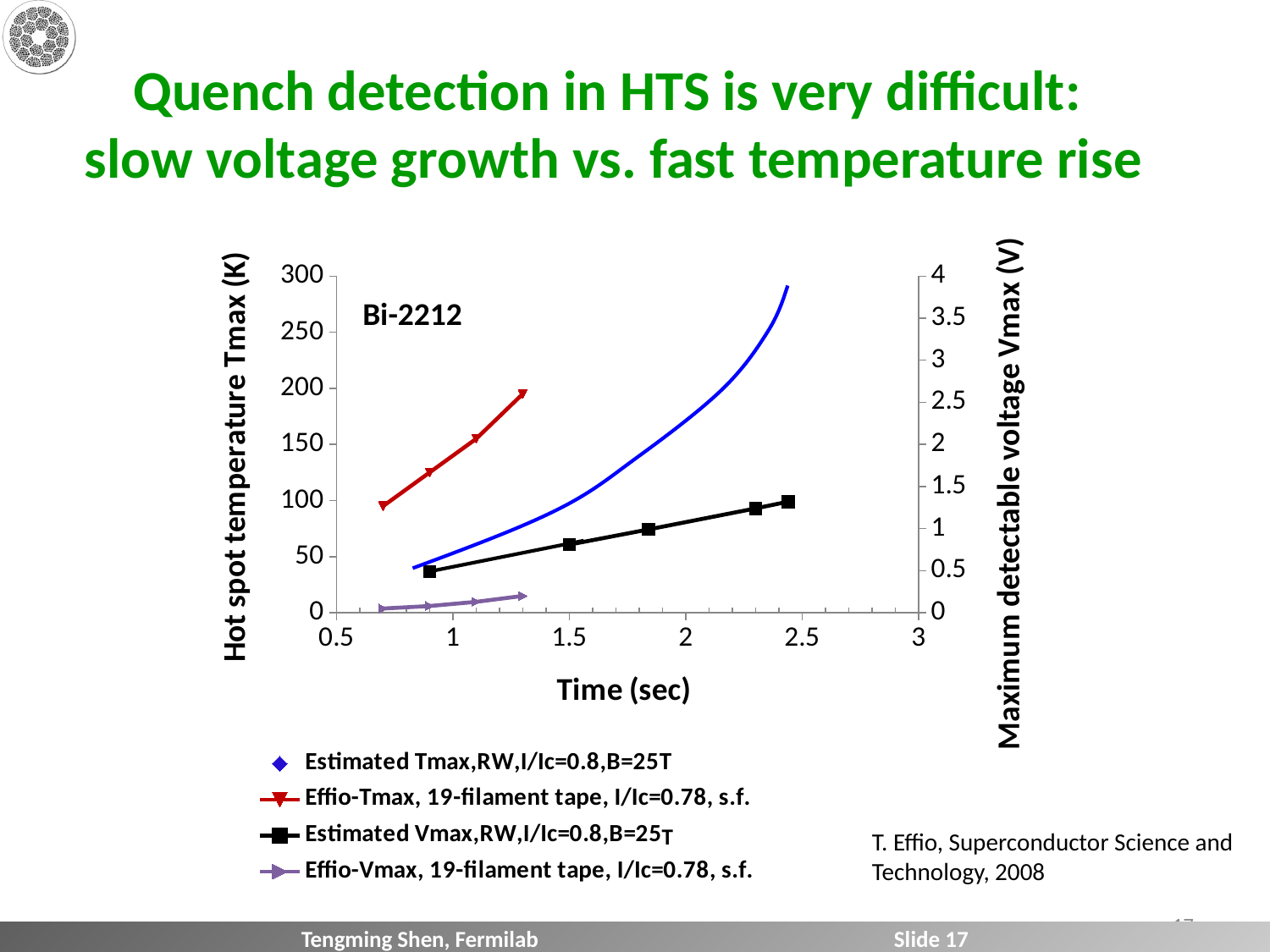
How many series does the legend list? 4 What material is named in the annotation inside the plot area? Bi-2212 Which series reaches the highest hot spot temperature on the chart? Estimated Tmax,RW,I/Ic=0.8,B=25T Is the highest value reached by the Estimated Vmax,RW,I/Ic=0.8,B=25T curve greater or less than 1 on the right axis? greater What kind of chart is shown on the slide? line chart Is the highest value reached by the Effio-Tmax, 19-filament tape curve greater or less than 150? greater Is the highest value reached by the Effio-Vmax, 19-filament tape curve greater or less than 0.5 on the right axis? less At time 1 sec, which is higher: the Effio-Tmax, 19-filament tape curve or the Estimated Tmax,RW,I/Ic=0.8,B=25T curve? Effio-Tmax, 19-filament tape What is the label of the x axis? Time (sec) Does the Estimated Vmax,RW,I/Ic=0.8,B=25T curve rise or fall as time increases? rise Does the Estimated Tmax,RW,I/Ic=0.8,B=25T curve rise or fall as time increases? rise